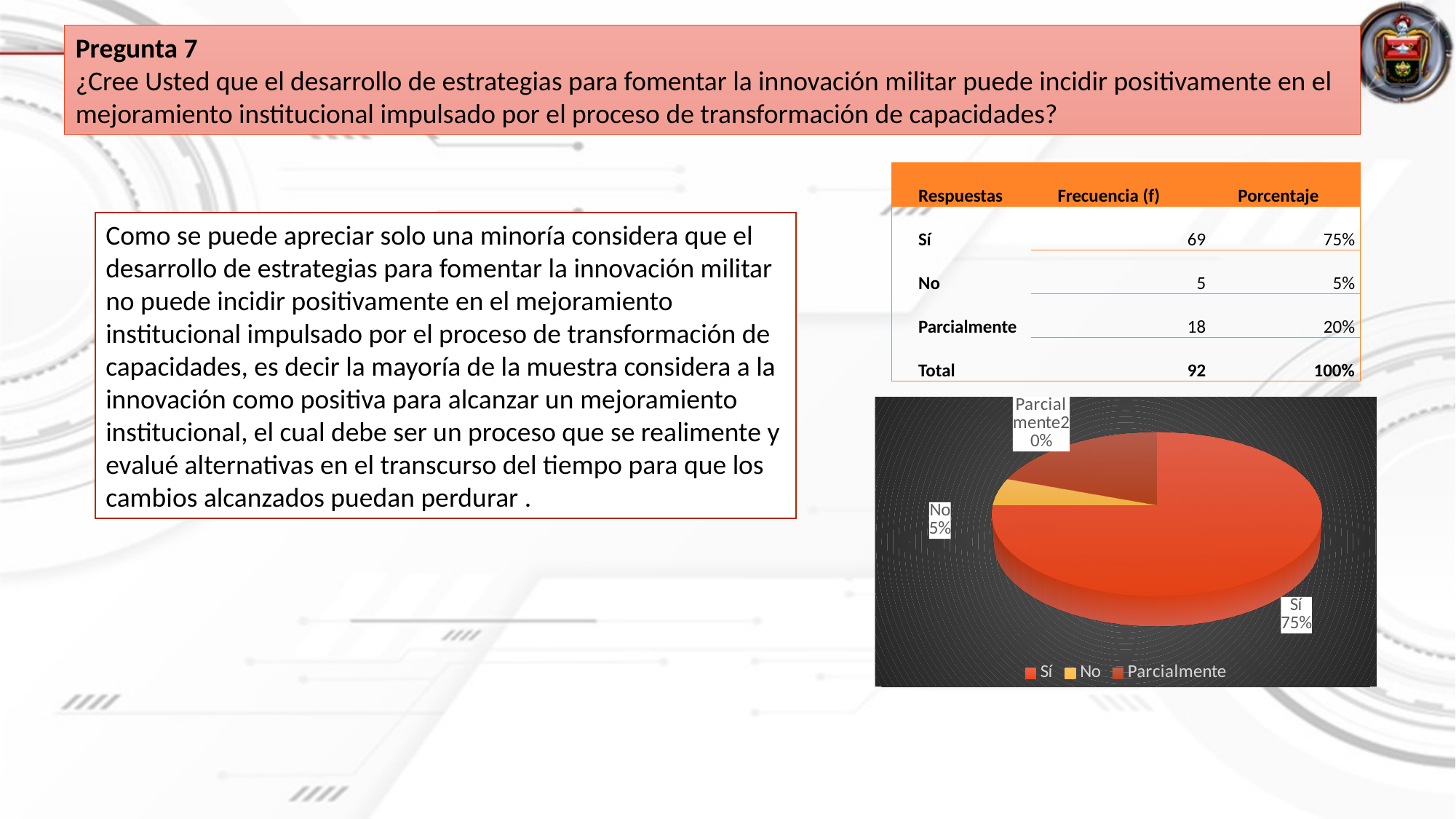
What kind of chart is shown on the slide? pie chart Which category has the smallest slice in the pie chart? No What colour is the No slice in the pie chart? yellow What percentage does the pie chart show for No? 5% Which slice is larger in the pie chart, No or Parcialmente? Parcialmente What colour is the Sí slice in the pie chart? red Which category has the largest slice in the pie chart? Sí How many slices does the pie chart have? 3 What percentage does the pie chart show for Sí? 75% What is the difference in percentage points between the Sí slice and the Parcialmente slice? 55 What percentage does the pie chart show for Parcialmente? 20% How many entries does the pie chart legend list? 3